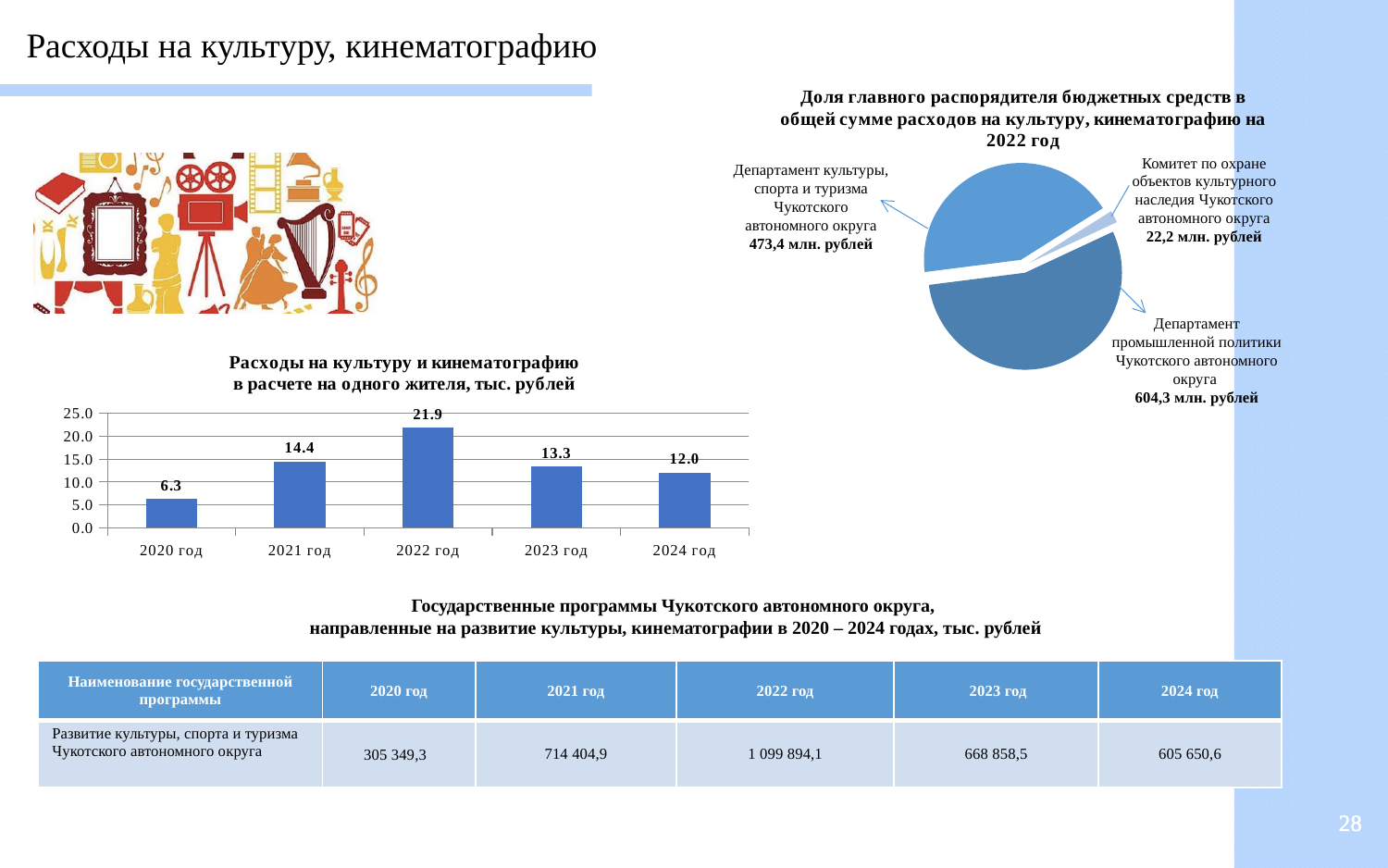
On the bar chart 'Расходы на культуру и кинематографию в расчете на одного жителя', how many years are shown? 5 On the bar chart 'Расходы на культуру и кинематографию в расчете на одного жителя', what is the value for 2020 год? 6.3 On the bar chart 'Расходы на культуру и кинематографию в расчете на одного жителя', what is the difference between the values for 2022 год and 2020 год? 15.6 On the pie chart 'Доля главного распорядителя бюджетных средств', which entity has the smallest slice? Комитет по охране объектов культурного наследия Чукотского автономного округа On the pie chart 'Доля главного распорядителя бюджетных средств', how many slices are there? 3 On the bar chart 'Расходы на культуру и кинематографию в расчете на одного жителя', which is larger: the value for 2021 год or 2023 год? 2021 год What kind of chart is the chart 'Расходы на культуру и кинематографию в расчете на одного жителя'? bar chart On the bar chart 'Расходы на культуру и кинематографию в расчете на одного жителя', what is the value for 2022 год? 21.9 On the bar chart 'Расходы на культуру и кинематографию в расчете на одного жителя', which year has the highest value? 2022 год On the bar chart 'Расходы на культуру и кинематографию в расчете на одного жителя', do the values rise or fall from 2022 год to 2024 год? fall On the pie chart 'Доля главного распорядителя бюджетных средств', what is the value for Департамент промышленной политики Чукотского автономного округа? 604,3 млн. рублей On the bar chart 'Расходы на культуру и кинематографию в расчете на одного жителя', which year has the lowest value? 2020 год